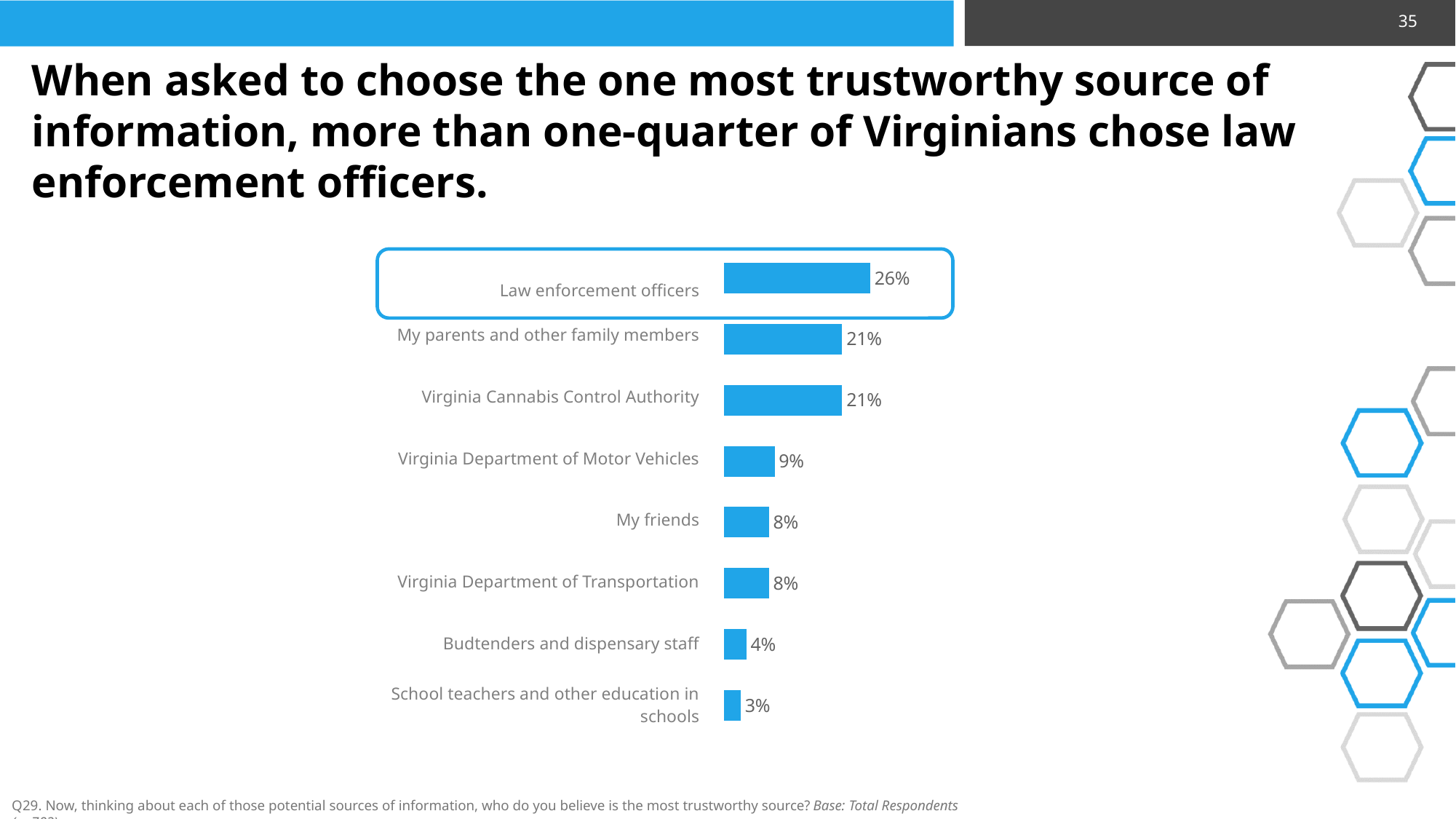
Which category has the lowest value? School teachers and other education in schools What percentage chose law enforcement officers as the most trustworthy source? 26% What is the difference between the values for Virginia Cannabis Control Authority and My friends? 13 percentage points Which category has the highest value? Law enforcement officers How many categories are shown in the chart? 8 What is the value for Virginia Department of Motor Vehicles? 9% What is the value for School teachers and other education in schools? 3% Which is larger, the value for Virginia Department of Motor Vehicles or the value for Budtenders and dispensary staff? Virginia Department of Motor Vehicles Which category is highlighted with a box outline on the chart? Law enforcement officers What is the value for Budtenders and dispensary staff? 4% What kind of chart is shown on the slide? Bar chart What is the difference between the values for Law enforcement officers and My parents and other family members? 5 percentage points